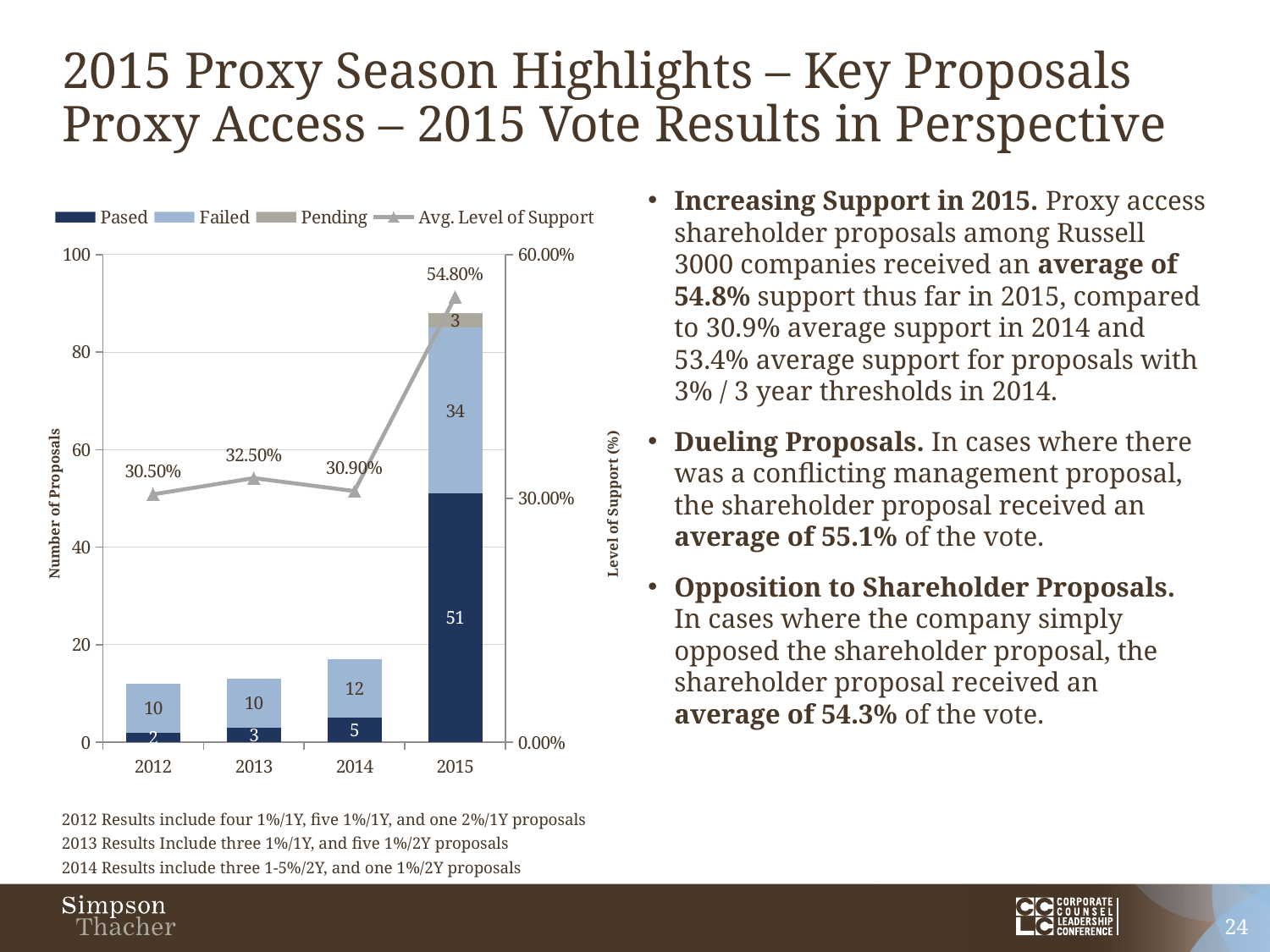
How many proposals are in the Pased segment for 2015? 51 Which year has the highest Avg. Level of Support? 2015 What is the Pending value shown for 2015? 3 How many series does the legend list? 4 What is the Avg. Level of Support value for 2015? 54.80% What is the difference between the Pased values for 2015 and 2014? 46 What is the label of the right-hand vertical axis? Level of Support (%) Which year has the lowest Avg. Level of Support? 2012 How many years are shown on the x axis? 4 How many proposals are in the Failed segment for 2014? 12 What is the total number of proposals in the stacked bar for 2015? 88 Which is larger, the Failed value for 2013 or the Failed value for 2014? 2014